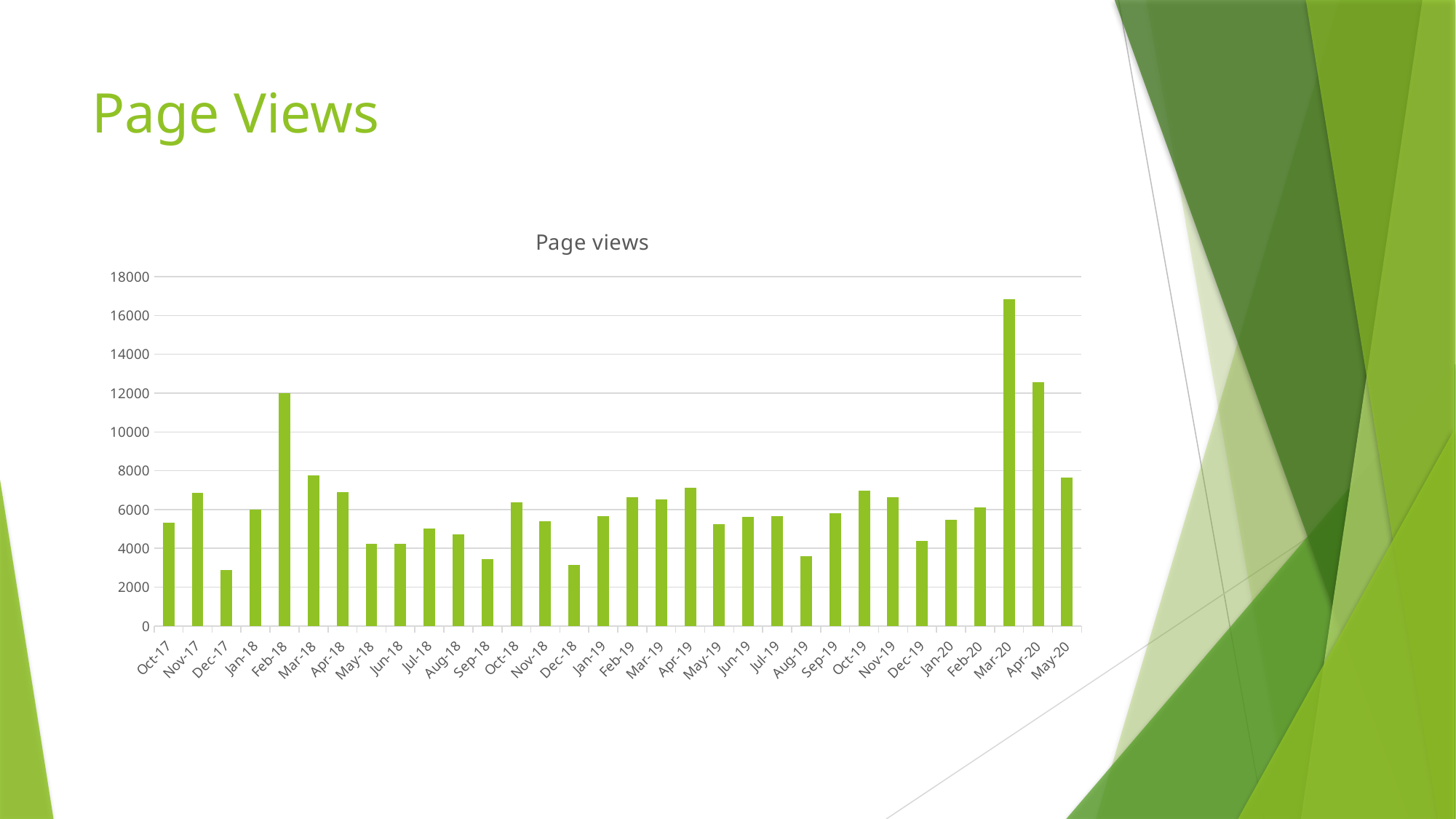
Is the value for Apr-19 greater or less than 6000? greater Is the value for Sep-18 greater or less than 4000? less Is the value for Apr-20 greater or less than 12000? greater How many months are plotted on the x axis? 32 What kind of chart is shown on the slide? bar chart Which month has the highest number of page views? Mar-20 Which is larger, the value for Feb-18 or the value for Mar-18? Feb-18 Which is larger, the value for Mar-20 or the value for Apr-20? Mar-20 What is the title of the chart? Page views